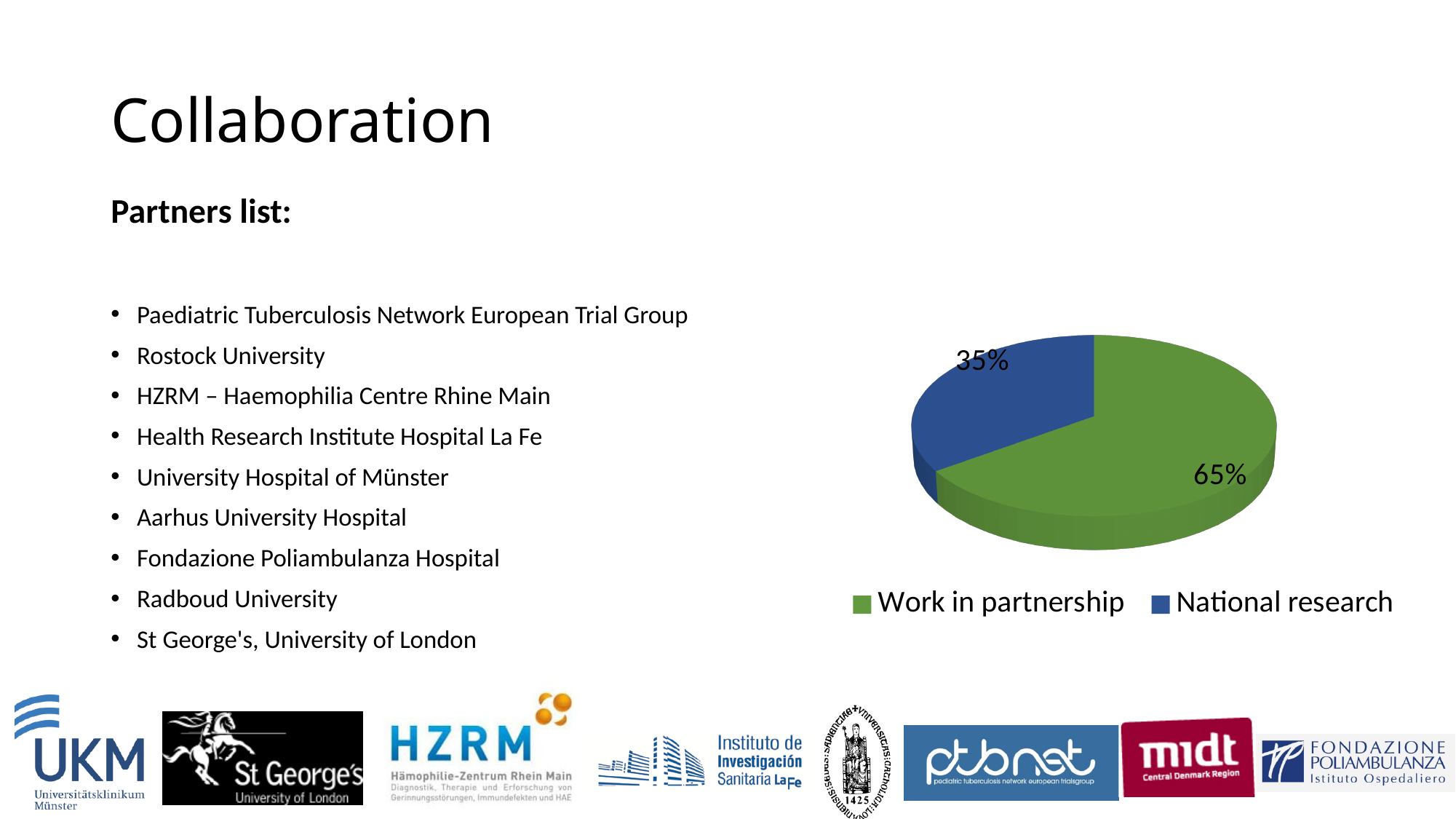
Which slice of the pie chart is the largest? Work in partnership Which slice of the pie chart is the smallest? National research What share of the pie chart is labelled "National research"? 35% What colour is the "Work in partnership" slice in the pie chart? Green What is the difference in percentage points between the "Work in partnership" and "National research" slices? 30 What colour is the "National research" slice in the pie chart? Blue What share of the pie chart is labelled "Work in partnership"? 65% How many slices does the pie chart have? 2 What type of chart is shown on the slide? Pie chart How many entries does the chart legend list? 2 Is the share for "Work in partnership" greater or less than 50%? greater Which is larger in the pie chart, "Work in partnership" or "National research"? Work in partnership